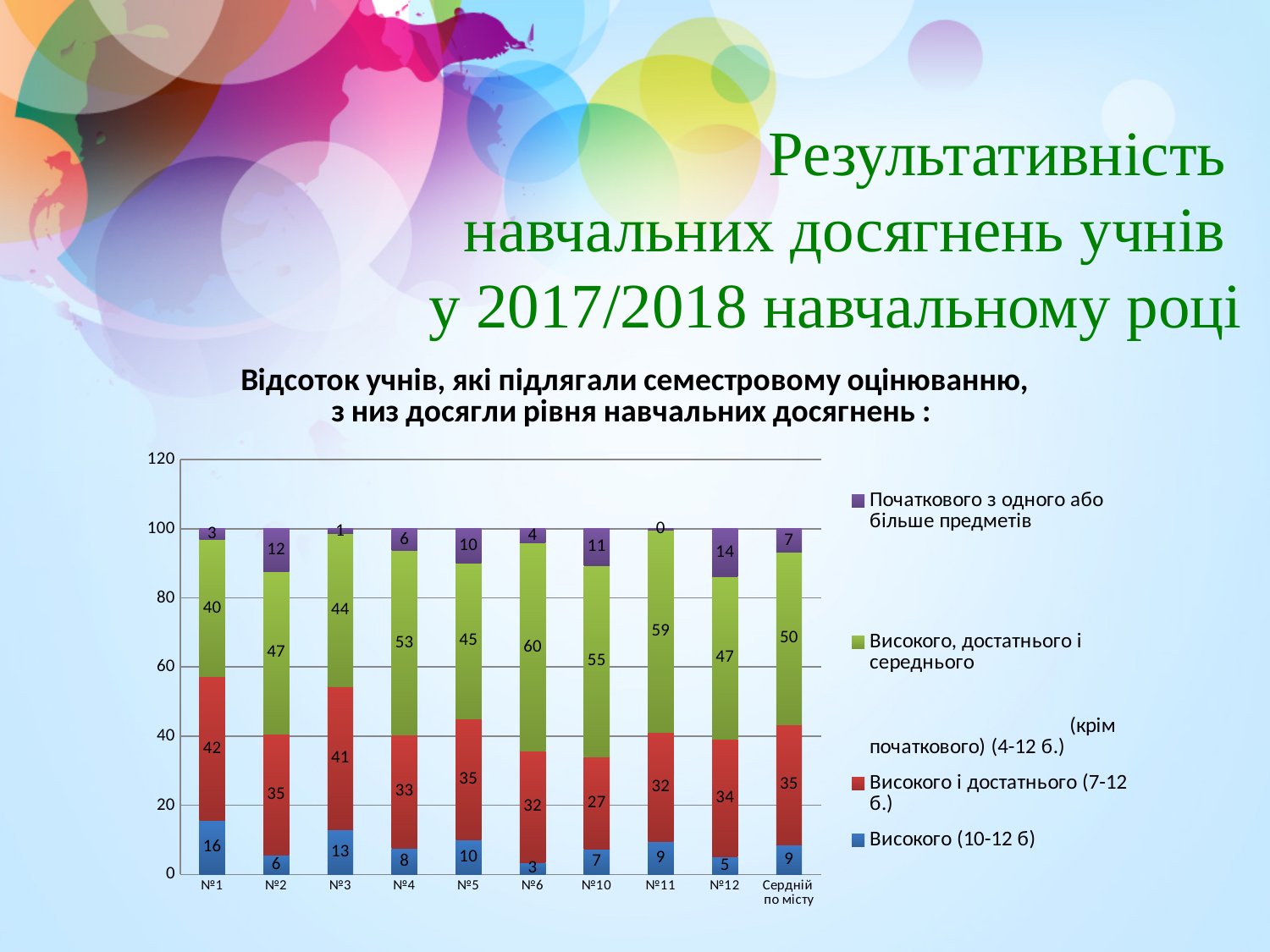
Which category has the lowest value in the "Початкового з одного або більше предметів" series? №11 What is the difference between the "Високого (10-12 б)" values for №1 and №2? 10 What is the value of the "Високого (10-12 б)" series for №1? 16 What is the value of the "Високого і достатнього (7-12 б.)" series for №10? 27 What is the value of the "Початкового з одного або більше предметів" series for №12? 14 Which is larger, the "Високого і достатнього (7-12 б.)" value for №3 or for №4? №3 How many series does the legend list? 4 What is the value of the "Високого, достатнього і середнього" series for "Сердній по місту"? 50 Which category has the highest value in the "Високого, достатнього і середнього" series? №6 What is the total of the stacked bar for №5? 100 What kind of chart is shown on the slide? Stacked bar chart How many categories are shown on the x axis? 10